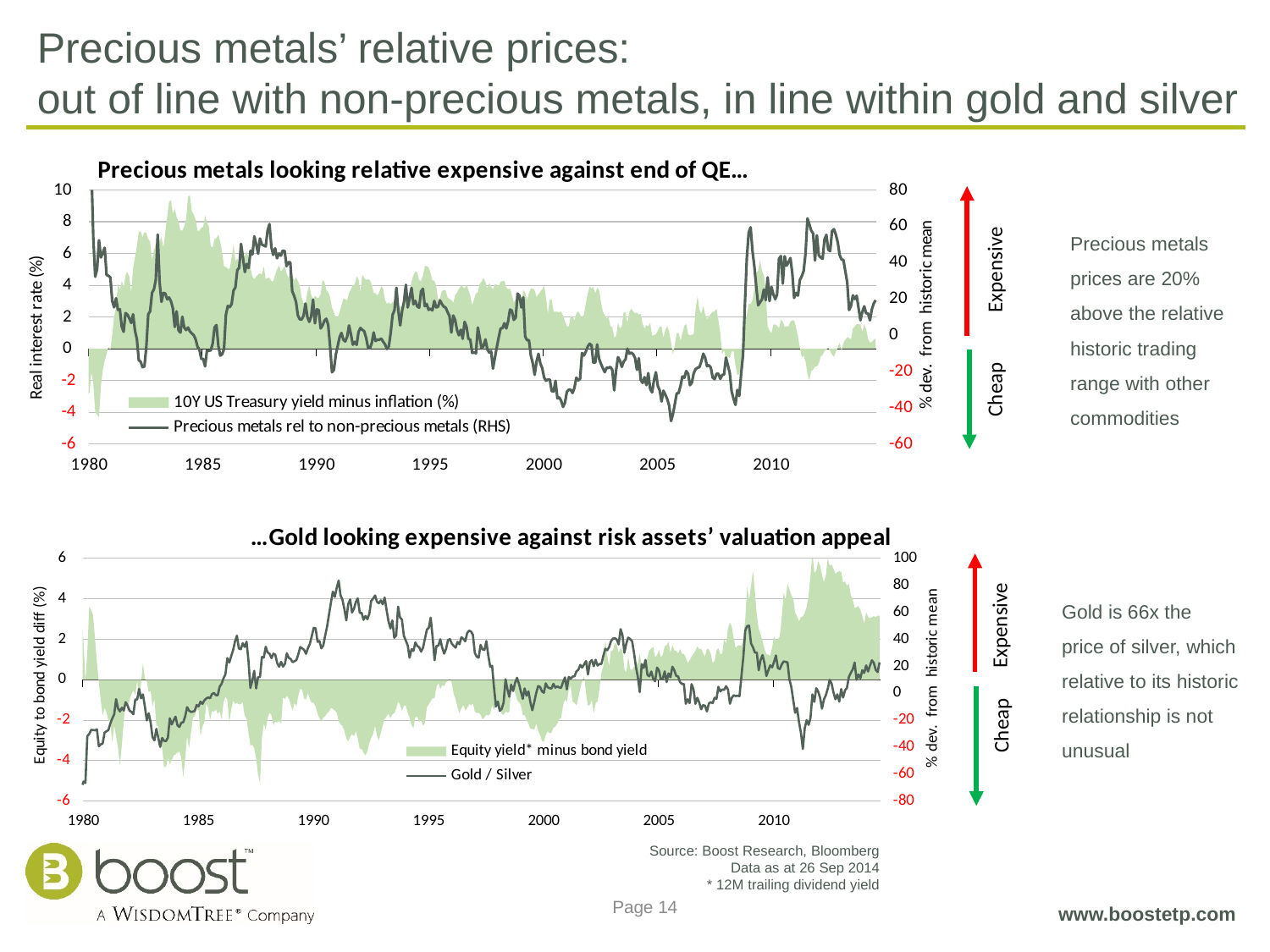
How many series does the legend of the bottom chart list? 2 In the top chart, which series is plotted on the right-hand axis? Precious metals rel to non-precious metals (RHS) In the top chart, is the value of the Precious metals rel to non-precious metals line around 2005 greater or less than 0 on the right-hand axis? less In the bottom chart, is the Gold / Silver line at its peak around 1991 greater or less than 40 on the right-hand axis? greater In the bottom chart, is the Gold / Silver line at its low point around 2011 greater or less than 0 on the right-hand axis? less What kind of chart is the top chart titled "Precious metals looking relative expensive against end of QE…"? Line chart with a shaded area series What is the lowest value shown on the left-hand axis of the top chart? -6 How many series does the legend of the top chart list? 2 What is the title of the bottom chart? …Gold looking expensive against risk assets' valuation appeal What is the highest value shown on the right-hand axis of the bottom chart? 100